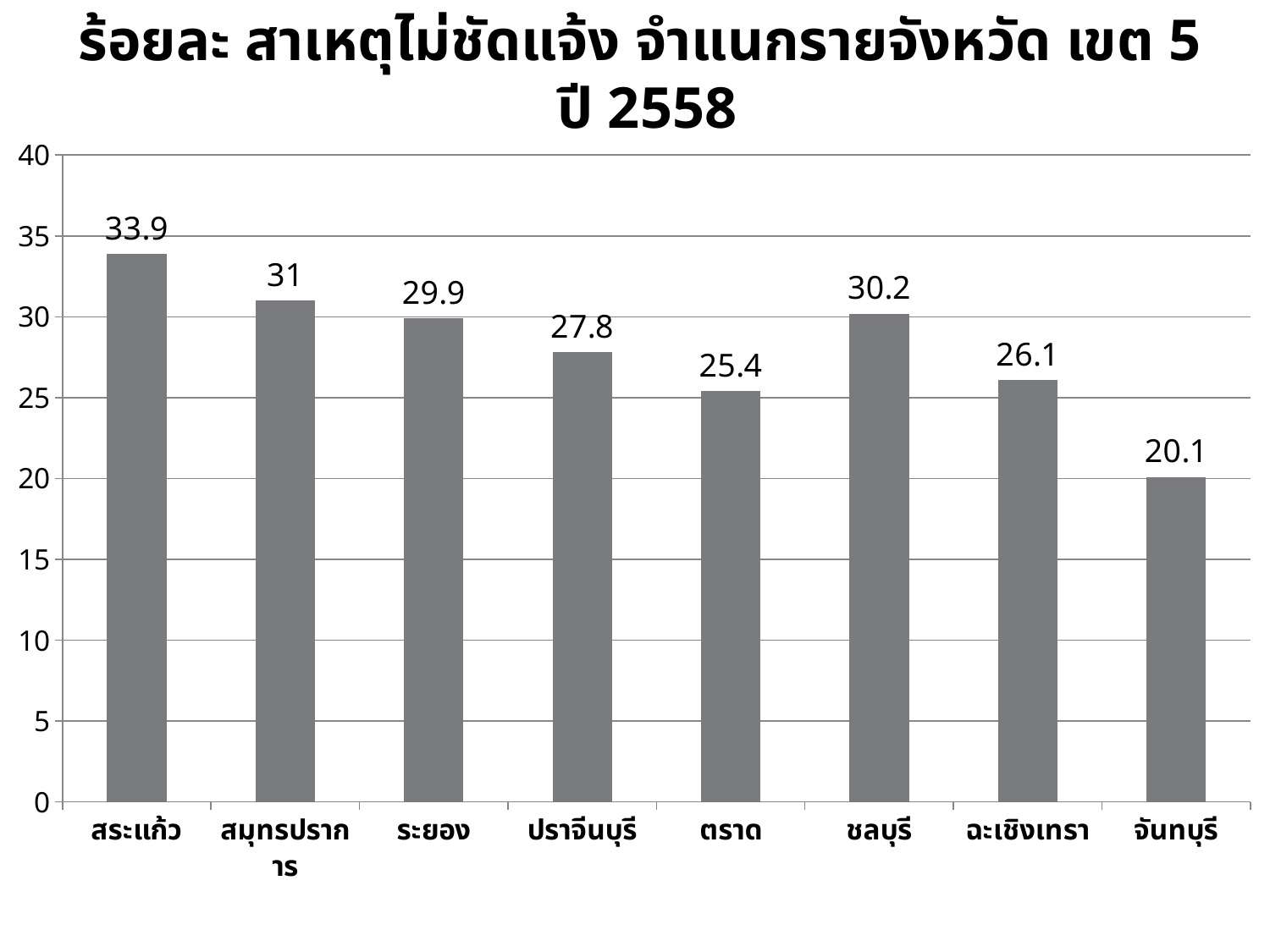
What is the title of the chart? ร้อยละ สาเหตุไม่ชัดแจ้ง จำแนกรายจังหวัด เขต 5 ปี 2558 Which province has the lowest value? จันทบุรี What is the difference between the values for สระแก้ว and จันทบุรี? 13.8 What is the value for สระแก้ว? 33.9 How many provinces are shown on the chart? 8 What is the difference between the values for ชลบุรี and ฉะเชิงเทรา? 4.1 Is the value for ปราจีนบุรี greater or less than 30? less Which is larger, the value for สมุทรปราการ or the value for ระยอง? สมุทรปราการ What is the value for ตราด? 25.4 What kind of chart is shown on the slide? bar chart Which province has the highest value? สระแก้ว What is the value for จันทบุรี? 20.1